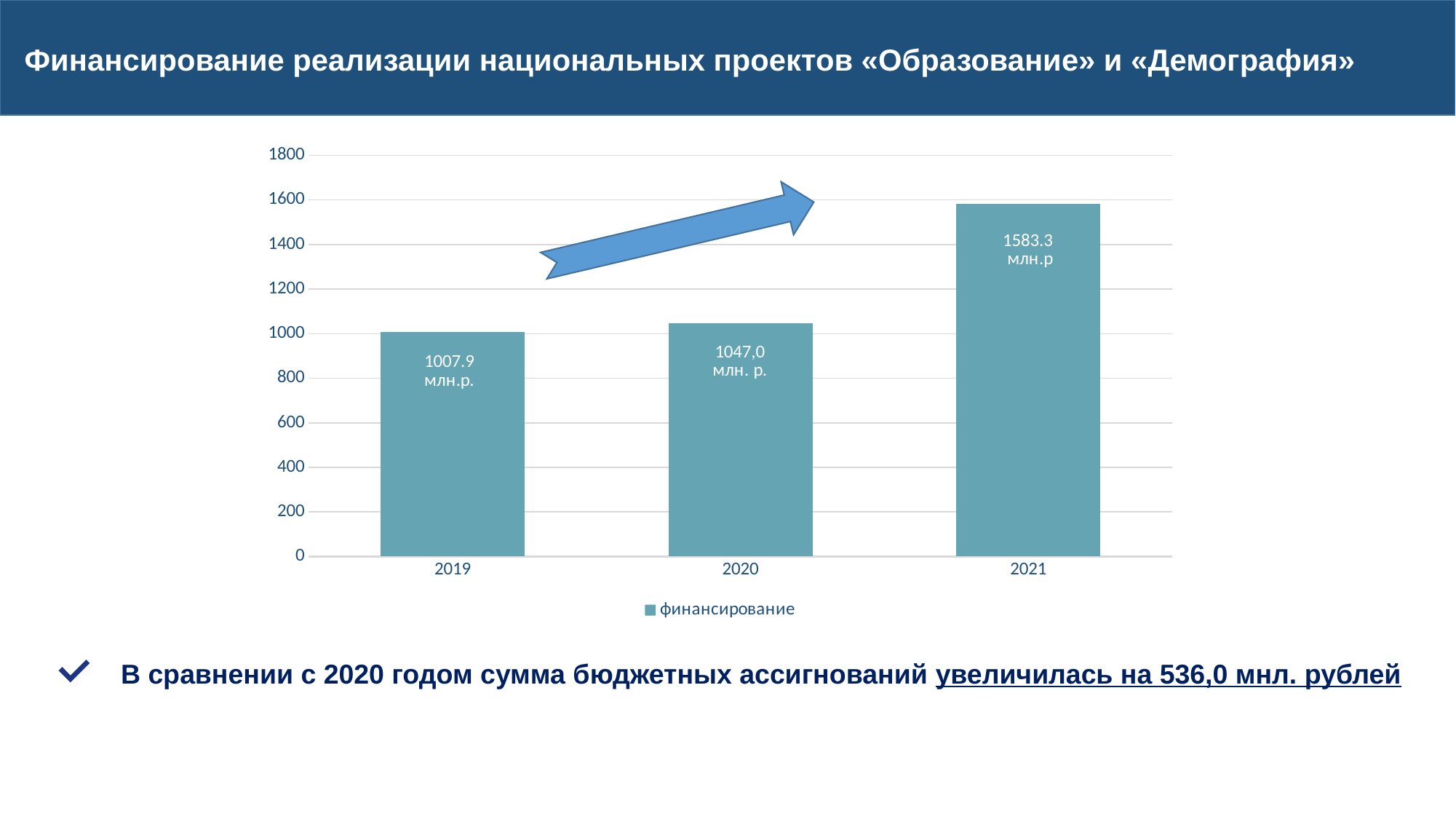
Is the value for 2021 greater or less than 1400? greater How many series does the legend list? 1 Which year has the highest value? 2021 Do the values rise or fall from 2019 to 2021? rise What is the value shown for 2019? 1007.9 млн.р. What kind of chart is shown on the slide? bar chart By how much does the value for 2020 exceed the value for 2019? 39.1 Which year has the lowest value? 2019 Which is larger, the value for 2021 or the value for 2020? 2021 How many years are shown on the x axis? 3 What is the value shown for 2021? 1583.3 млн.р What is the value shown for 2020? 1047,0 млн. р.